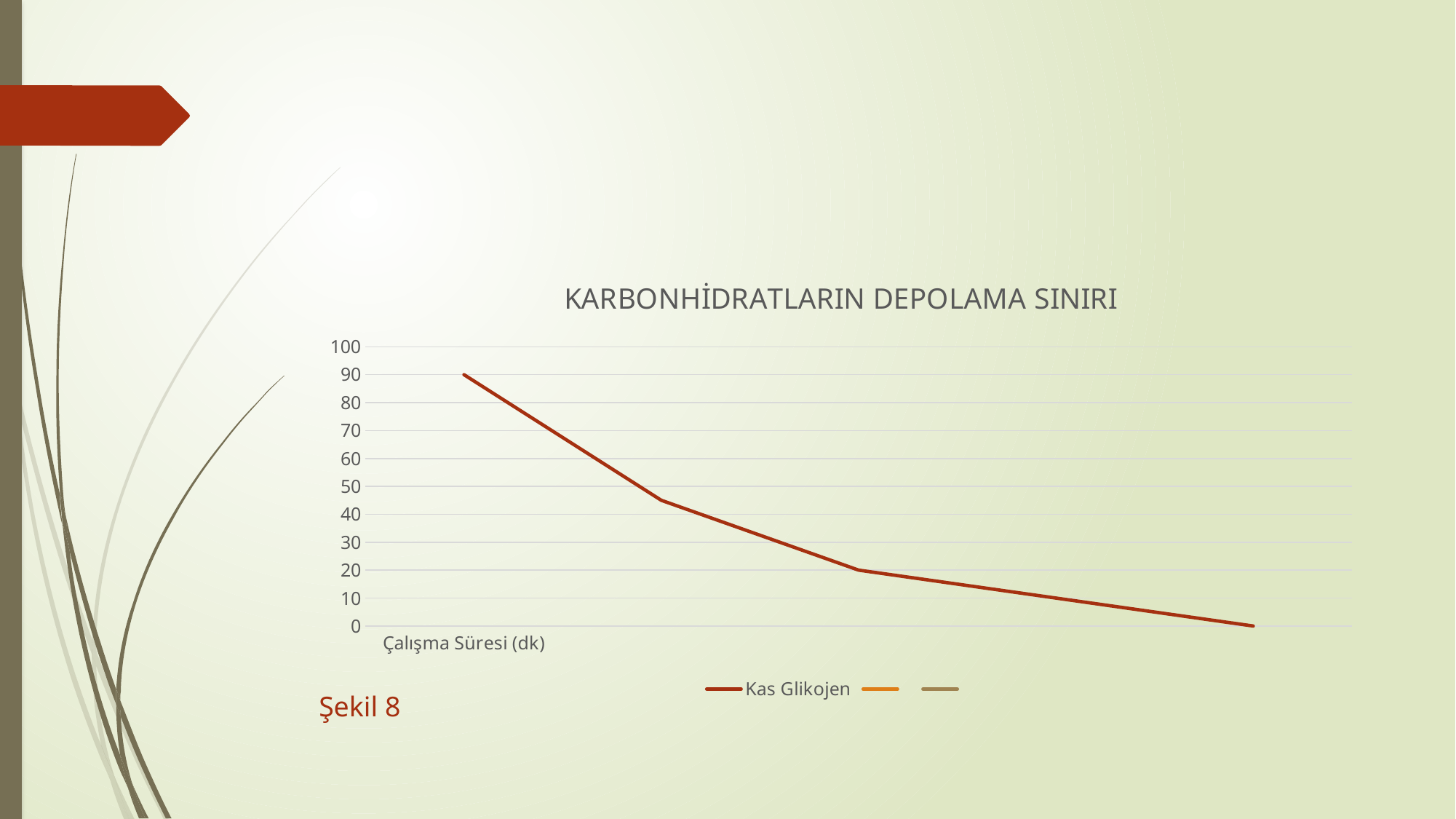
Which point on the Kas Glikojen line has the highest value? the first point What is the value of the first point on the Kas Glikojen line? 90 What is the title of the chart? KARBONHİDRATLARIN DEPOLAMA SINIRI What kind of chart is shown on the slide? line chart Is the value of the second point on the Kas Glikojen line greater or less than 40? greater Is the value of the second point on the Kas Glikojen line greater or less than 50? less Is the value of the third point on the Kas Glikojen line greater or less than 30? less Do the values of the Kas Glikojen line rise or fall along the x axis? fall What is the name of the series shown in the legend with a label? Kas Glikojen What is the value of the last point on the Kas Glikojen line? 0 Which is larger, the value of the first point or the value of the third point on the Kas Glikojen line? the first point